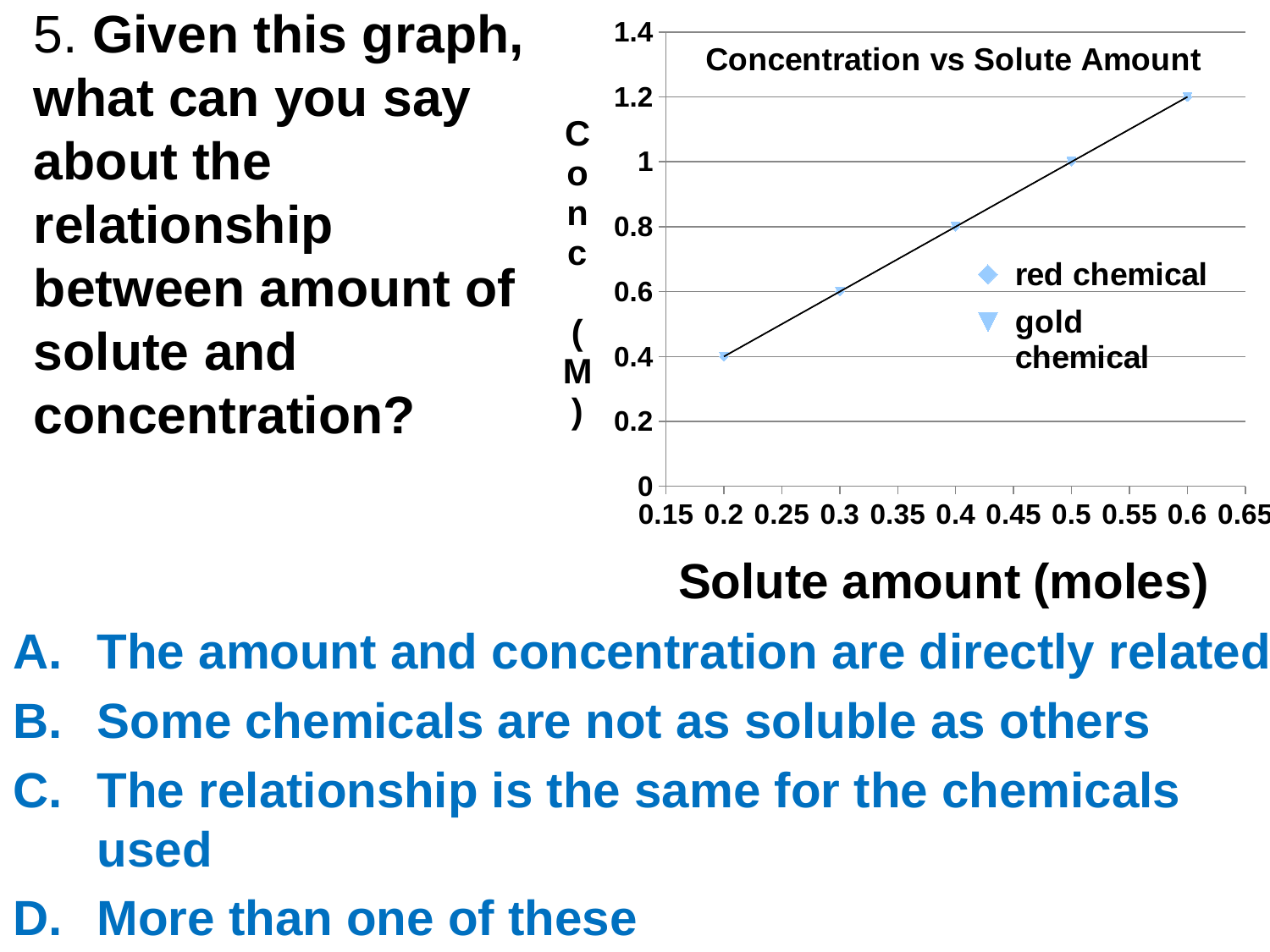
What is the concentration (M) when the solute amount is 0.4 moles? 0.8 At which solute amount is the concentration lowest? 0.2 What is the difference in concentration (M) between a solute amount of 0.6 moles and 0.2 moles? 0.8 What is the concentration (M) when the solute amount is 0.6 moles? 1.2 At which solute amount is the concentration highest? 0.6 What is the concentration (M) when the solute amount is 0.2 moles? 0.4 What is the title of the chart? Concentration vs Solute Amount What are the two series named in the chart legend? red chemical, gold chemical How many series does the chart legend list? 2 Does the concentration rise or fall as the solute amount increases along the x axis? rise What is the concentration (M) when the solute amount is 0.5 moles? 1